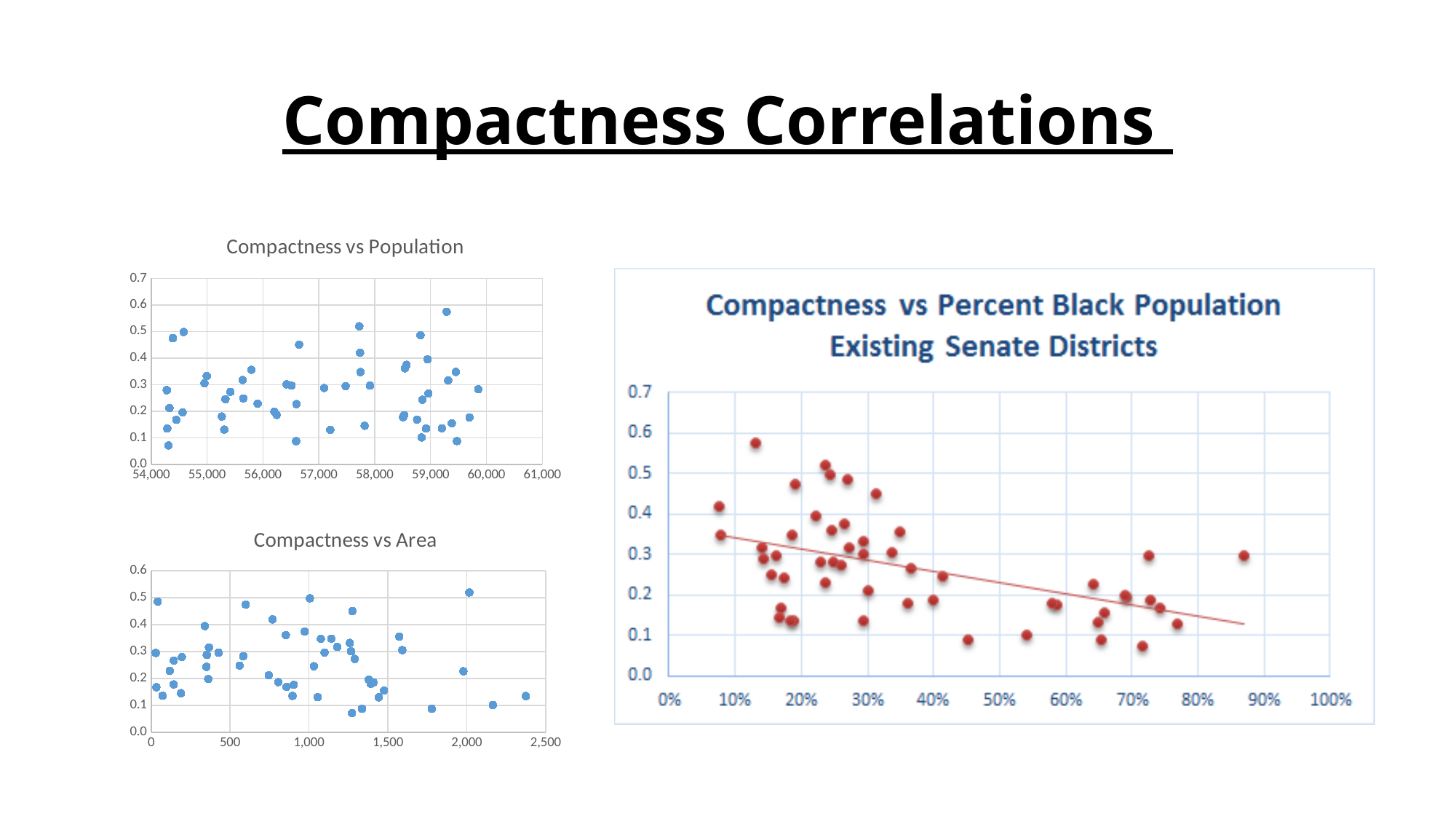
In 'Compactness vs Percent Black Population Existing Senate Districts', is the compactness of the rightmost point greater or less than 0.2? greater In 'Compactness vs Percent Black Population Existing Senate Districts', does the trend line rise or fall as percent black population increases? fall What is the title of the chart on the right side of the slide? Compactness vs Percent Black Population Existing Senate Districts What kind of chart is the chart on the right side of the slide? scatter chart In 'Compactness vs Percent Black Population Existing Senate Districts', is the highest plotted compactness value greater or less than 0.5? greater What kind of chart is 'Compactness vs Population'? scatter chart In 'Compactness vs Population', is the lowest plotted compactness value greater or less than 0.1? less How many charts are shown on the slide? 3